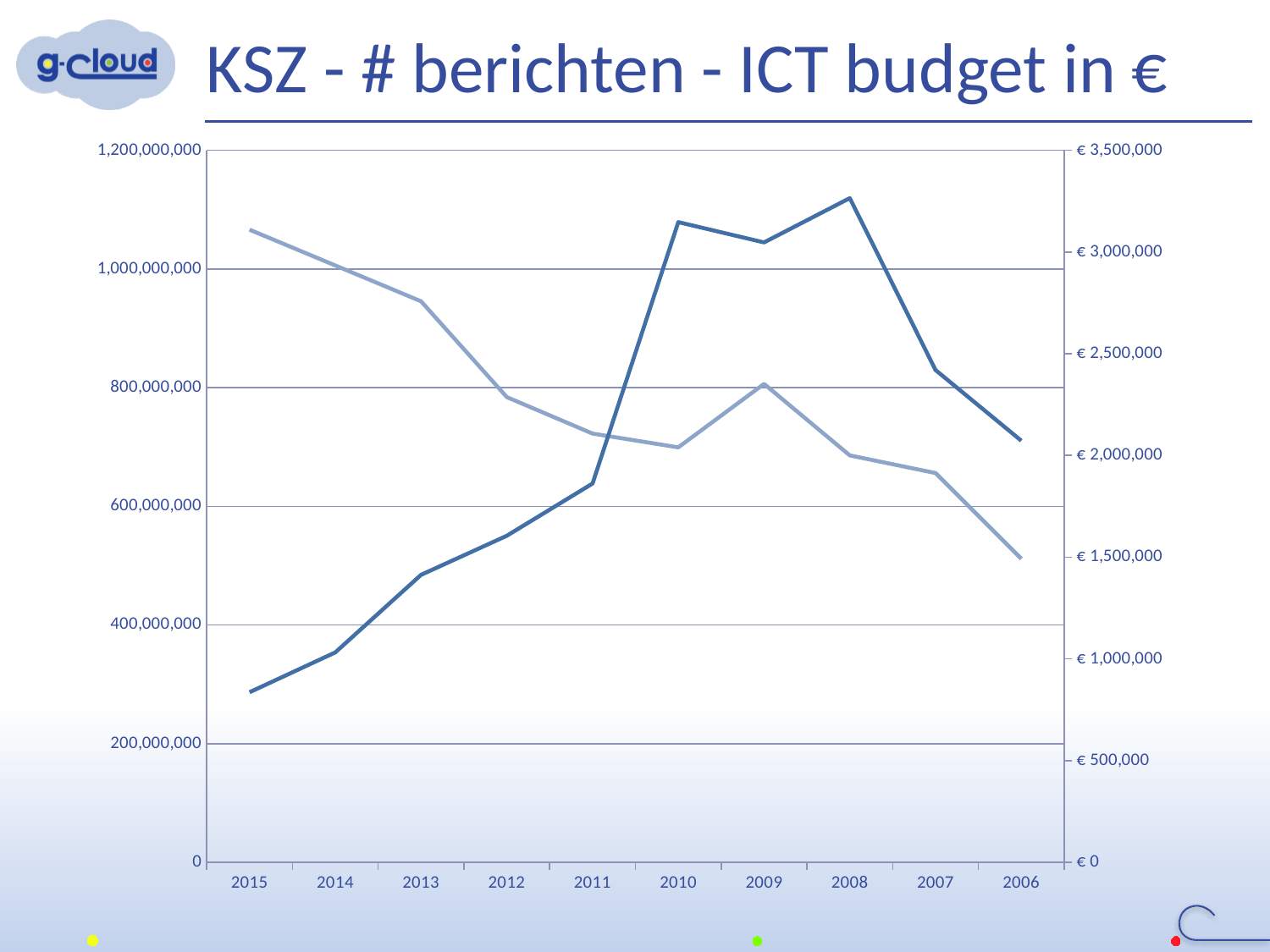
In which year does the darker line reach its highest point? 2008 How many years are shown on the x axis of the chart? 10 Is the lighter line higher in 2009 or in 2010? 2009 Does the lighter line generally rise or fall from 2015 to 2012 along the x axis? fall In which year is the lighter line at its lowest point? 2006 How many lines are plotted on the chart? 2 In which year is the darker line at its lowest point? 2015 What is the highest tick value shown on the right-hand axis? € 3,500,000 Is the darker line higher in 2010 or in 2011? 2010 What is the title of the chart slide? KSZ - # berichten - ICT budget in € What kind of chart is shown on the slide? line chart In which year is the lighter line at its highest point? 2015